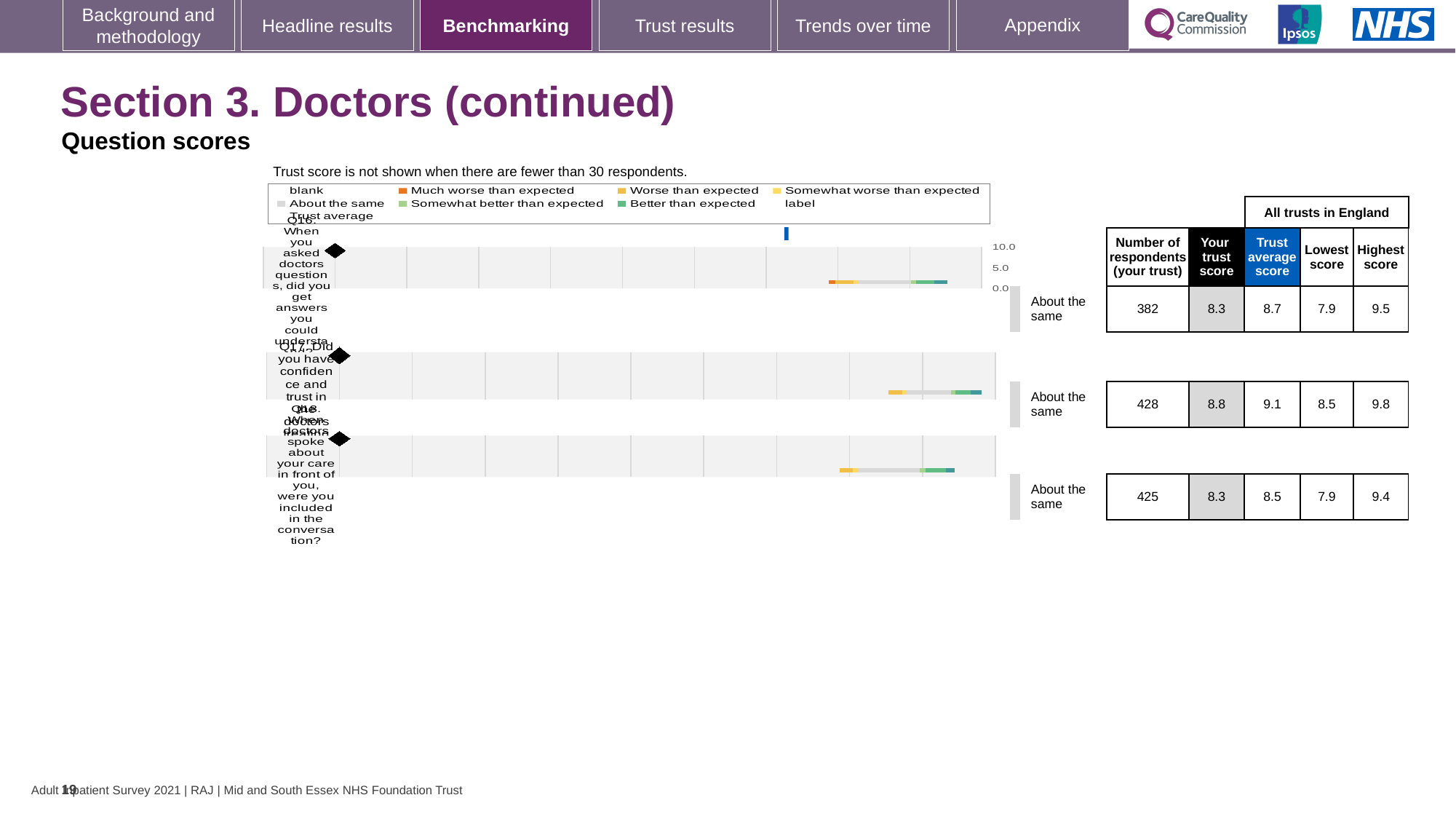
For Q18, how much higher is the trust average score than your trust score? 0.2 What is the trust average score for Q16 (answers you could understand)? 8.7 What benchmark category is shown for Q17? About the same What is the lowest score across all trusts in England for Q18? 7.9 What is the maximum value shown on the chart's score axis? 10.0 For Q16, which is larger: your trust score or the trust average score? Trust average score How many questions are plotted in the question scores chart? 3 What kind of chart is used to show the question scores on this slide? bar chart What is the 'Your trust score' for Q17 (confidence and trust in the doctors)? 8.8 Which question has the highest 'Your trust score'? Q17 What is the difference between the highest score and the lowest score for Q17? 1.3 How many respondents answered Q18 (included in the conversation) at your trust? 425